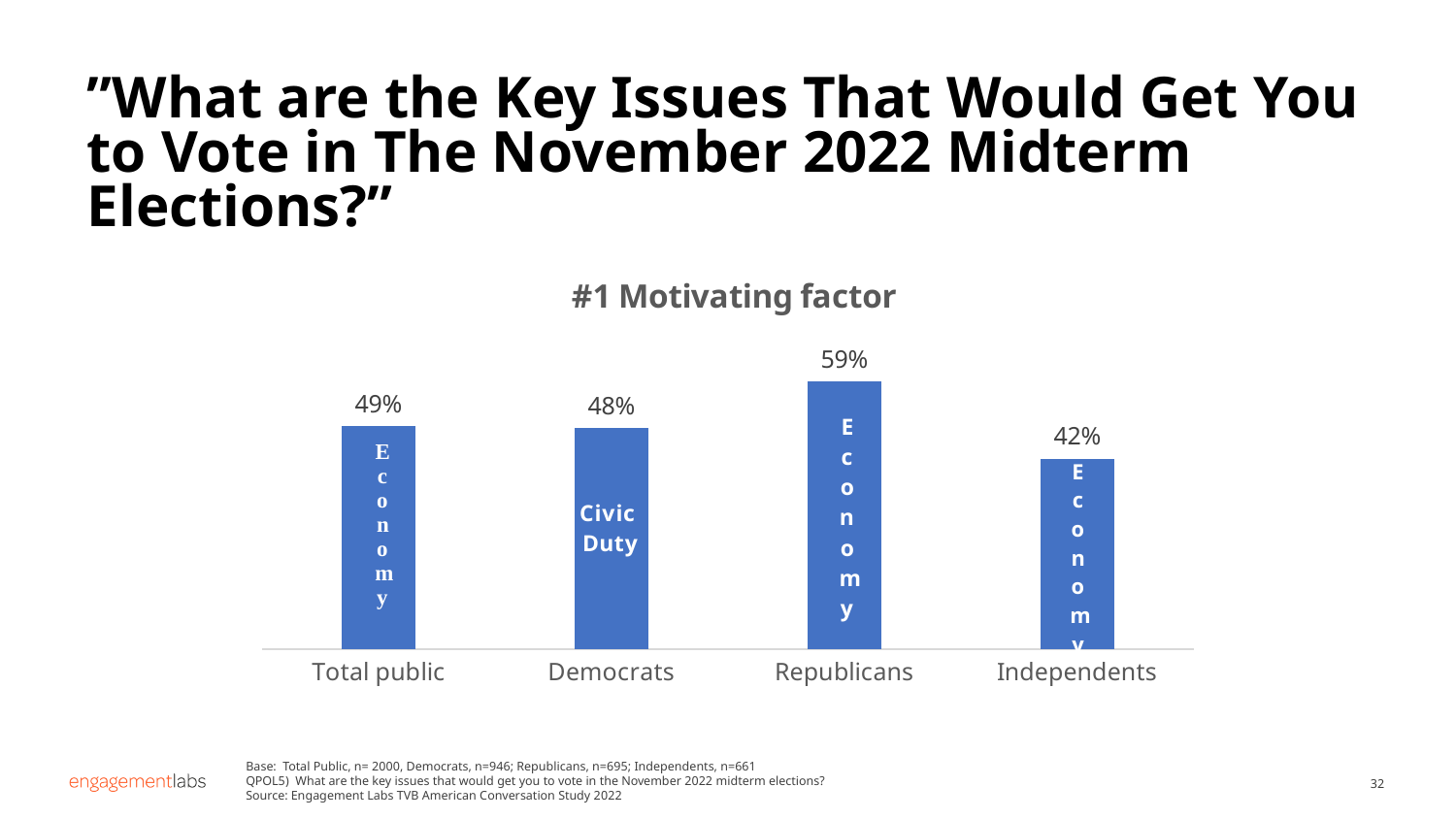
Which is larger, the value for Republicans or the value for Total public? Republicans What is the value for Republicans? 59% What is the value for Independents? 42% Which category has the highest value? Republicans What is the value for Democrats? 48% What is the difference between the values for Total public and Democrats? 1% Which category has the lowest value? Independents How many categories are shown on the x axis? 4 What is the difference between the values for Republicans and Independents? 17% What kind of chart is this? Bar chart What is the #1 motivating factor labelled on the bar for Democrats? Civic Duty What is the value for Total public? 49%